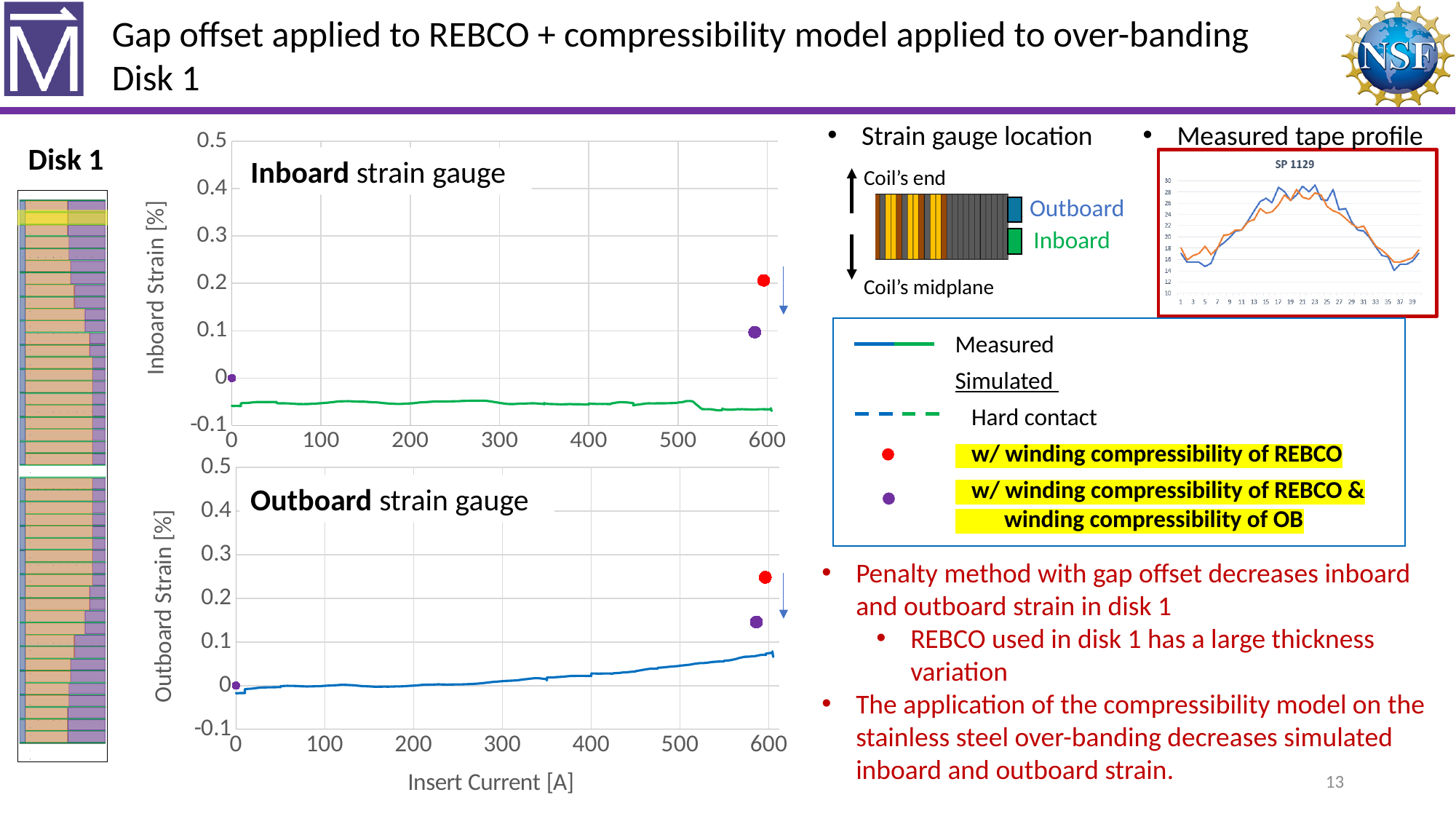
In the Outboard strain gauge chart, is the red simulated point greater or less than 0.2? greater According to the legend, what does the purple dot represent? w/ winding compressibility of REBCO & winding compressibility of OB In the Inboard strain gauge chart, which is higher: the red simulated point or the purple simulated point? the red simulated point In the Inboard strain gauge chart, is the red simulated point (w/ winding compressibility of REBCO) greater or less than 0.1? greater In the Inboard strain gauge chart, is the measured strain at 600 A greater or less than 0? less At 600 A, which measured strain is larger: the inboard strain gauge or the outboard strain gauge? outboard strain gauge In the Outboard strain gauge chart, does the measured strain rise or fall as insert current increases from 0 to 600 A? rise What is the x-axis label shared by the Inboard and Outboard strain gauge charts? Insert Current [A] In the Outboard strain gauge chart, which simulated point is higher: the red one or the purple one? the red one What kind of chart is the Inboard strain gauge chart? line chart